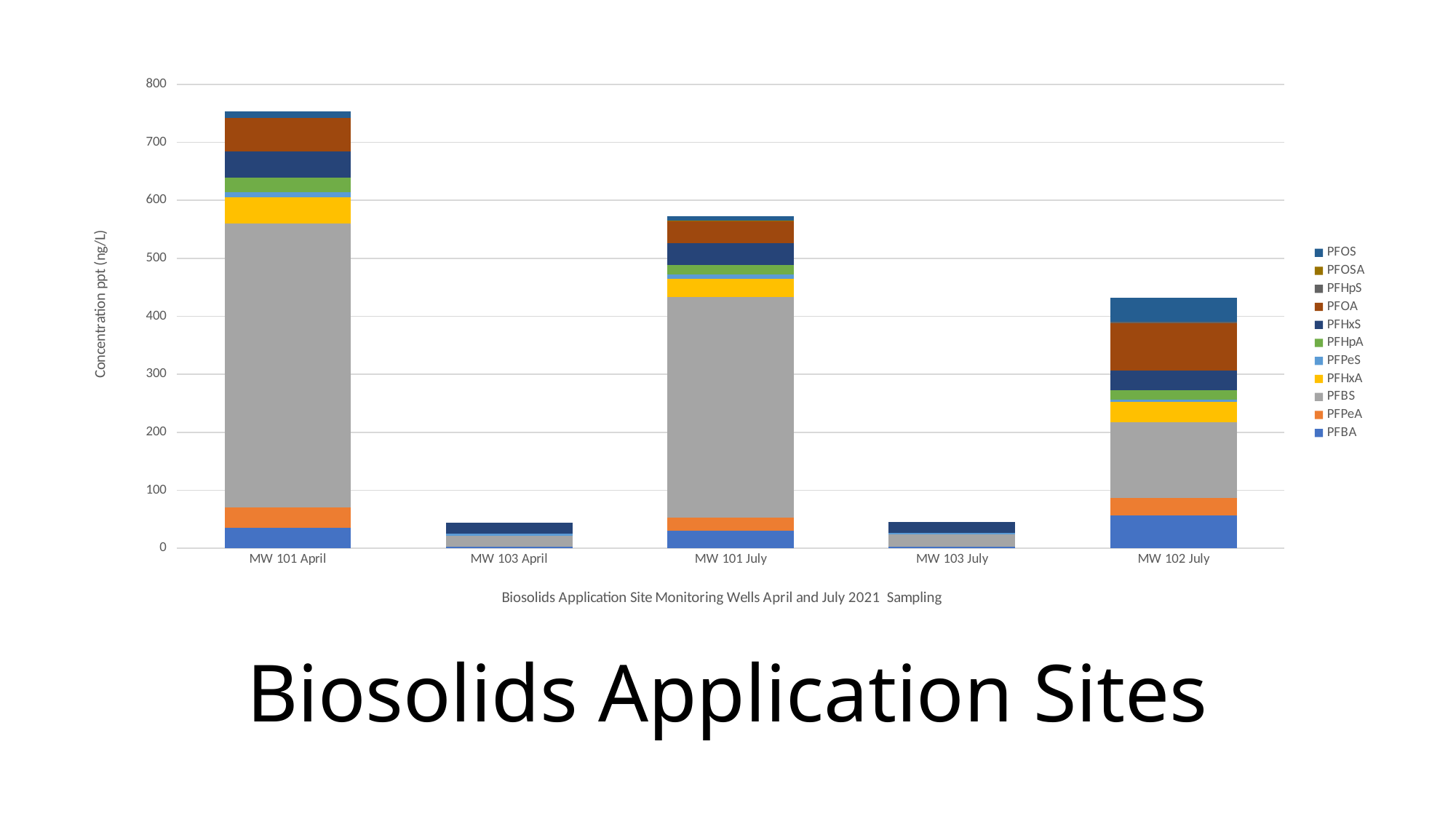
Which sample has the highest total concentration? MW 101 April Is the total concentration for MW 102 July greater or less than 400? greater What is the title of the chart? Biosolids Application Site Monitoring Wells April and July 2021 Sampling Is the total concentration for MW 101 April greater or less than 700? greater What kind of chart is shown on the slide? Stacked bar chart How many monitoring well samples (categories) are shown on the x axis? 5 Which has the larger total concentration, MW 101 April or MW 101 July? MW 101 April What is the label of the y axis? Concentration ppt (ng/L) Is the total concentration for MW 101 July greater or less than 500? greater Which has the larger total concentration, MW 101 July or MW 102 July? MW 101 July How many series does the legend list? 11